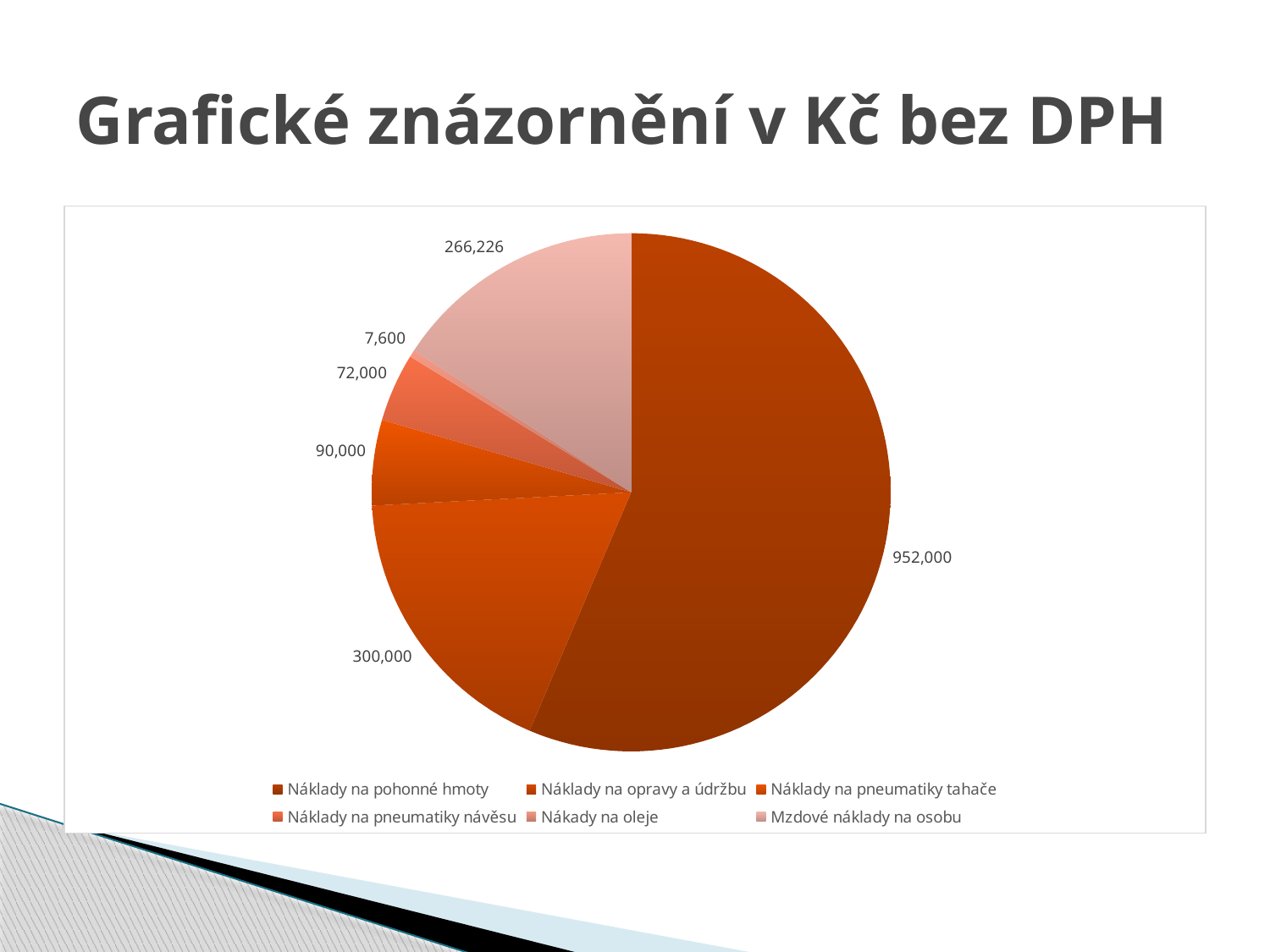
What is the difference between the values for Náklady na pohonné hmoty and Náklady na opravy a údržbu? 652,000 How many slices does the pie chart have? 6 What is the difference between the values for Náklady na pneumatiky tahače and Náklady na pneumatiky návěsu? 18,000 What is the title of the slide containing the chart? Grafické znázornění v Kč bez DPH Which category has the largest slice of the pie? Náklady na pohonné hmoty Which is larger, the value for Náklady na opravy a údržbu or the value for Mzdové náklady na osobu? Náklady na opravy a údržbu What type of chart is shown on the slide? pie chart What is the value for Náklady na opravy a údržbu? 300,000 What is the value for Náklady na pohonné hmoty? 952,000 What is the value for Nákady na oleje? 7,600 What is the value for Mzdové náklady na osobu? 266,226 Which category has the smallest slice of the pie? Nákady na oleje